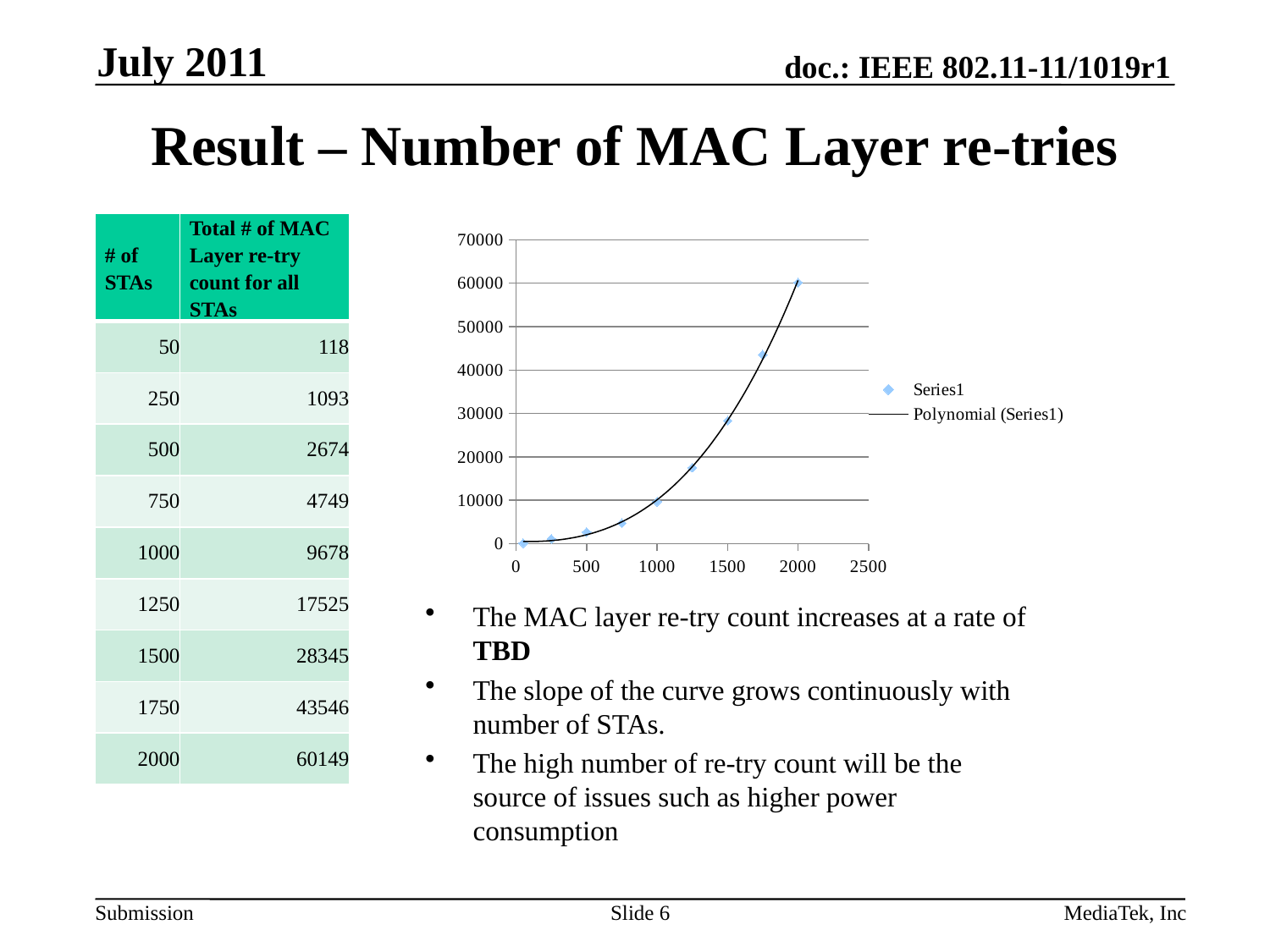
Is the plotted value at 1250 STAs greater or less than 20000? less At which number of STAs is the plotted re-try count lowest? 50 Which is larger, the plotted value at 1500 STAs or at 1750 STAs? 1750 STAs What is the total MAC layer re-try count for 2000 STAs, as printed on the slide? 60149 How many entries does the chart legend list? 2 At which number of STAs is the plotted re-try count highest? 2000 What kind of chart is shown on the slide? scatter chart What are the two entries listed in the chart legend? Series1 and Polynomial (Series1) Is the plotted value at 1750 STAs greater or less than 40000? greater Do the plotted values rise or fall as the number of STAs increases along the x axis? rise Is the plotted value at 2000 STAs greater or less than 50000? greater How many data points are plotted in the chart? 9